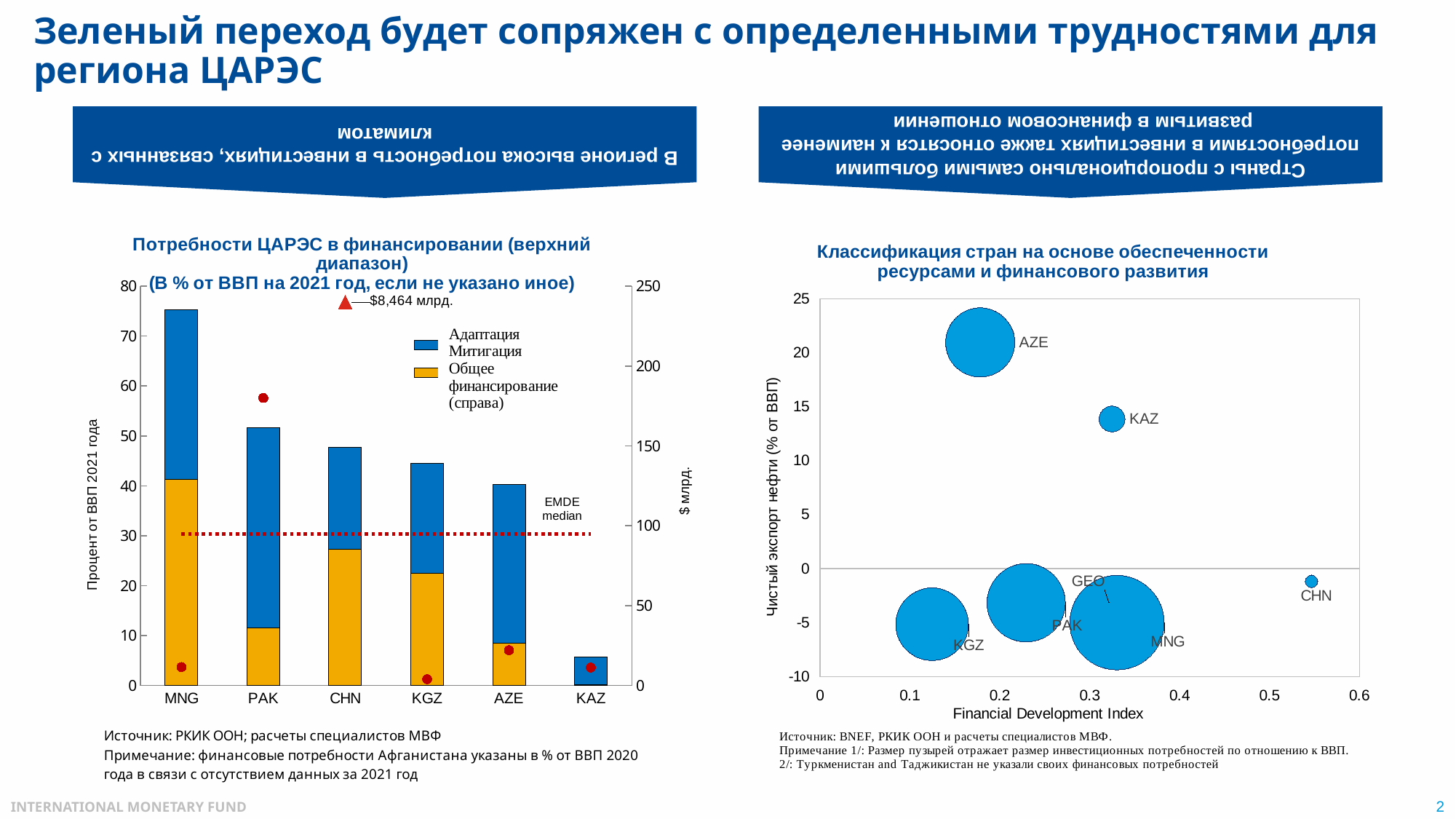
How many countries are shown on the x axis of the left chart, 'Потребности ЦАРЭС в финансировании'? 6 In the left chart, 'Потребности ЦАРЭС в финансировании', what value is printed next to the red triangle above CHN? $8,464 млрд. In the left chart, 'Потребности ЦАРЭС в финансировании', is the total bar for MNG greater or less than 70? greater In the left chart, 'Потребности ЦАРЭС в финансировании', which country has the shortest bar? KAZ In the right chart, 'Классификация стран на основе обеспеченности ресурсами и финансового развития', is the net oil export value for KAZ greater or less than 10? greater In the left chart, 'Потребности ЦАРЭС в финансировании', is the bar for KAZ greater or less than 10? less What kind of chart is the left chart, 'Потребности ЦАРЭС в финансировании (верхний диапазон)'? bar chart In the left chart, 'Потребности ЦАРЭС в финансировании', which bar is taller, MNG or AZE? MNG In the left chart, 'Потребности ЦАРЭС в финансировании', which country has the tallest bar? MNG In the right chart, 'Классификация стран на основе обеспеченности ресурсами и финансового развития', which country has the highest Financial Development Index? CHN In the right chart, 'Классификация стран на основе обеспеченности ресурсами и финансового развития', which country has the highest net oil export (Чистый экспорт нефти)? AZE In the left chart, 'Потребности ЦАРЭС в финансировании', do the bar totals rise or fall from left to right? fall